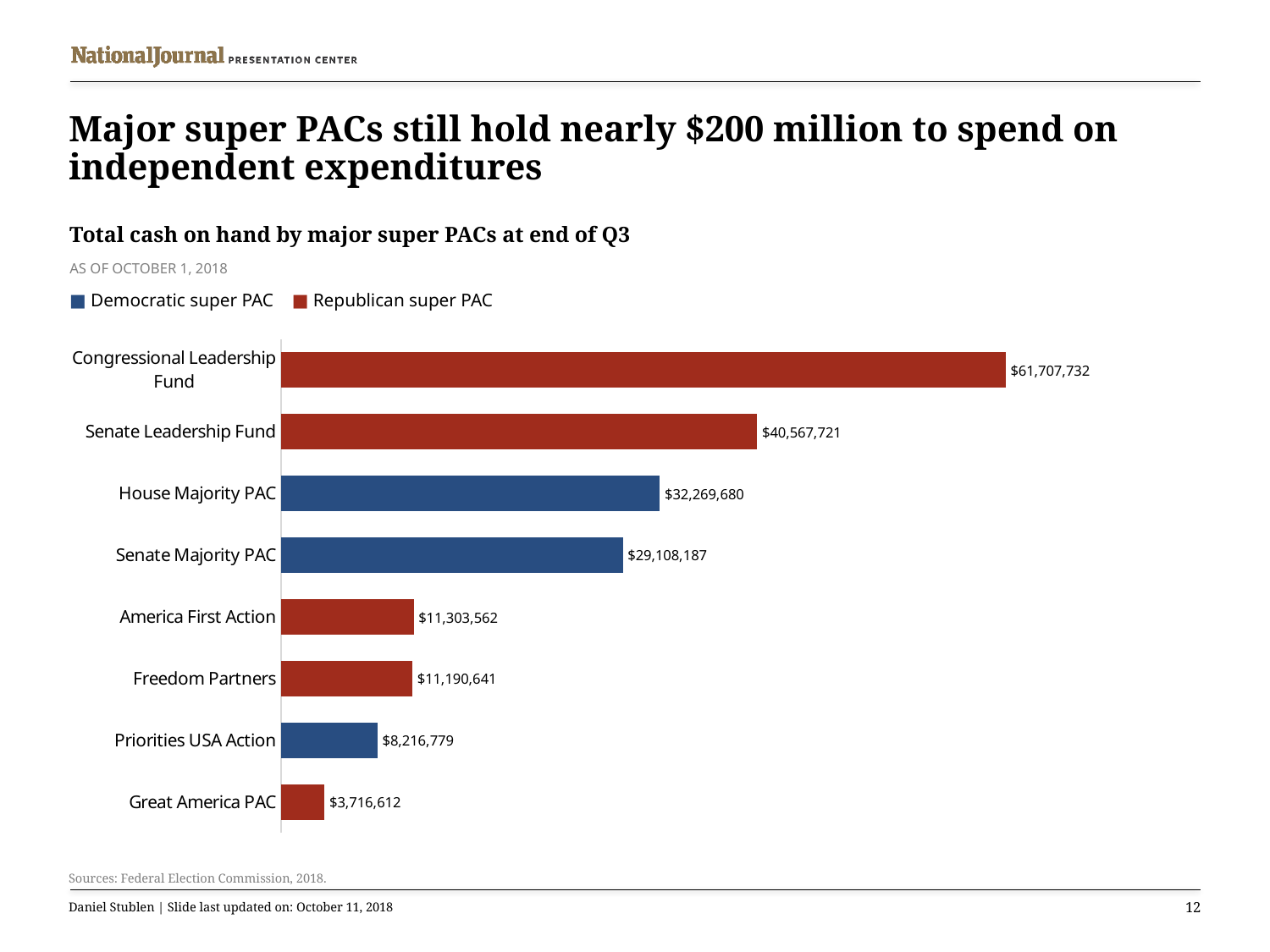
What is the total cash on hand for Priorities USA Action? $8,216,779 Which colour represents Democratic super PACs in the chart? Blue Which has more cash on hand, Senate Leadership Fund or House Majority PAC? Senate Leadership Fund What is the total cash on hand for the Congressional Leadership Fund? $61,707,732 What is the total cash on hand for Senate Majority PAC? $29,108,187 What is the difference in cash on hand between the Congressional Leadership Fund and the Senate Leadership Fund? $21,140,011 Which super PAC has the lowest cash on hand? Great America PAC How many super PACs are shown in the chart? 8 Which super PAC has the highest cash on hand? Congressional Leadership Fund How many series does the legend list? 2 What kind of chart is shown on the slide? Bar chart What is the difference in cash on hand between House Majority PAC and Senate Majority PAC? $3,161,493